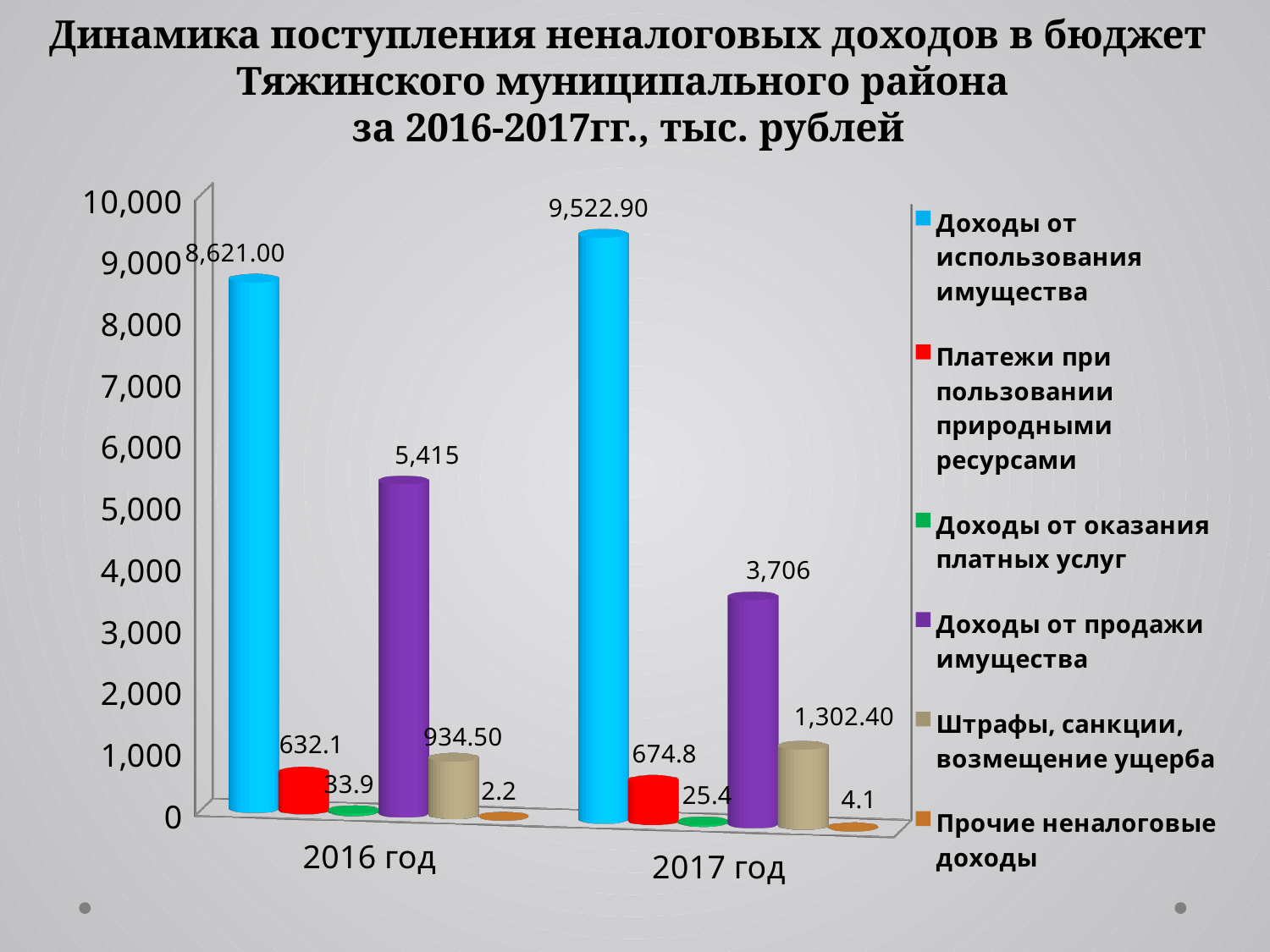
Which is larger: "Доходы от продажи имущества" in 2016 год or in 2017 год? 2016 год What is the value of "Штрафы, санкции, возмещение ущерба" for 2016 год? 934.50 Which series has the highest value in 2017 год? Доходы от использования имущества What is the value of "Прочие неналоговые доходы" for 2017 год? 4.1 What is the value of "Доходы от использования имущества" for 2017 год? 9,522.90 What is the difference between "Платежи при пользовании природными ресурсами" in 2017 год and in 2016 год? 42.7 How many series does the legend list? 6 What is the value of "Доходы от продажи имущества" for 2017 год? 3,706 What type of chart is shown on the slide? Bar chart How many year categories are shown on the x axis? 2 Which series has the lowest value in 2016 год? Прочие неналоговые доходы What is the value of "Доходы от использования имущества" for 2016 год? 8,621.00